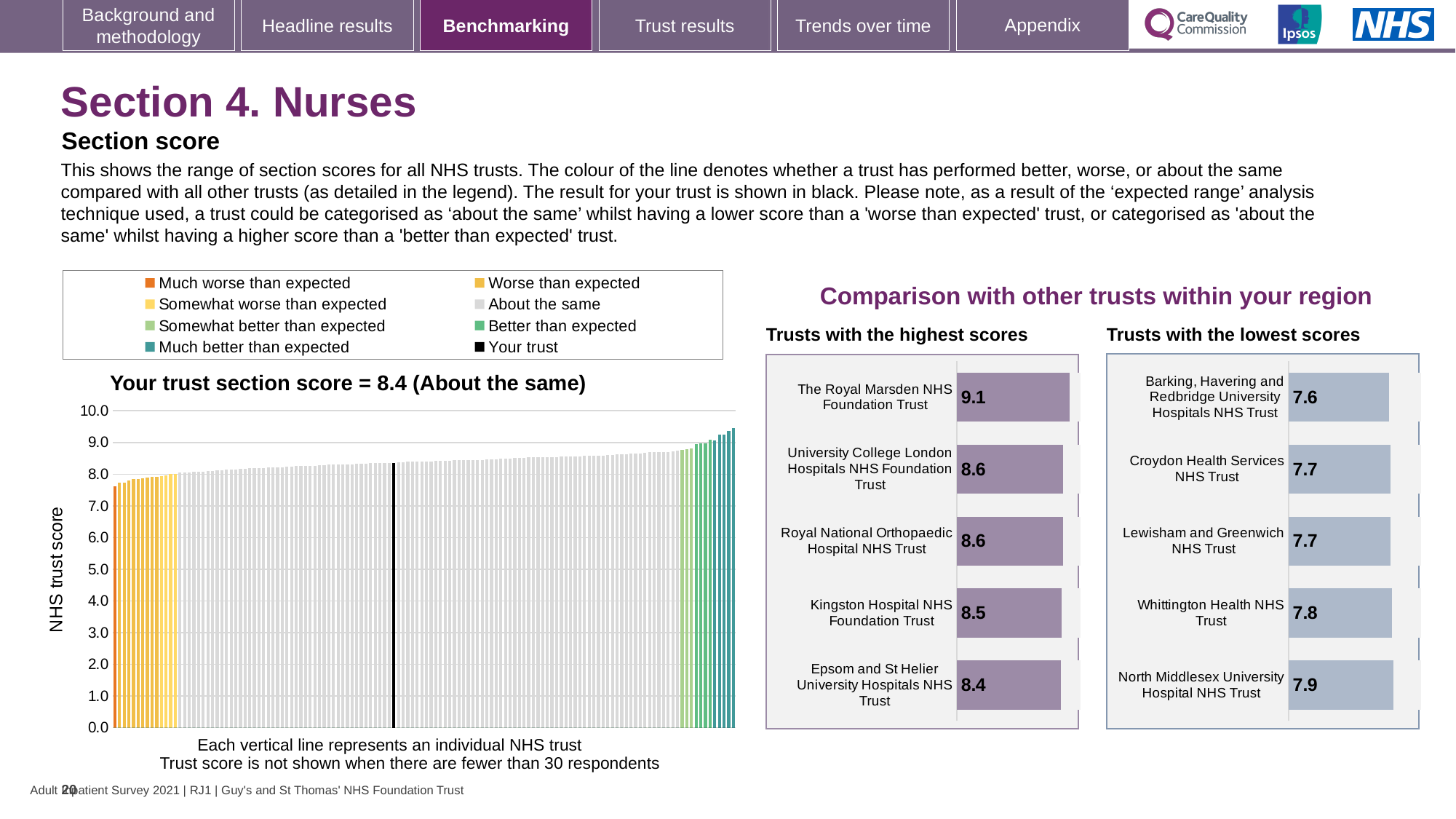
In the 'Trusts with the lowest scores' chart, which has the larger score: Whittington Health NHS Trust or North Middlesex University Hospital NHS Trust? North Middlesex University Hospital NHS Trust In the 'Trusts with the highest scores' chart, what is the difference between the scores of The Royal Marsden NHS Foundation Trust and Epsom and St Helier University Hospitals NHS Trust? 0.7 In the 'Trusts with the highest scores' chart, which trust has the highest score? The Royal Marsden NHS Foundation Trust In the 'Trusts with the lowest scores' chart, what is the score for Croydon Health Services NHS Trust? 7.7 In the 'Trusts with the highest scores' chart, what is the score for The Royal Marsden NHS Foundation Trust? 9.1 In the 'Trusts with the lowest scores' chart, what is the score for Barking, Havering and Redbridge University Hospitals NHS Trust? 7.6 How many entries does the legend above the main chart list? 8 In the 'Trusts with the lowest scores' chart, which trust has the lowest score? Barking, Havering and Redbridge University Hospitals NHS Trust What kind of chart is the main chart on the left showing all NHS trusts? Bar chart In the main chart on the left, what is the section score for your trust? 8.4 In the 'Trusts with the highest scores' chart, how many trusts are listed? 5 In the main chart on the left, do the trust scores rise or fall from left to right? Rise